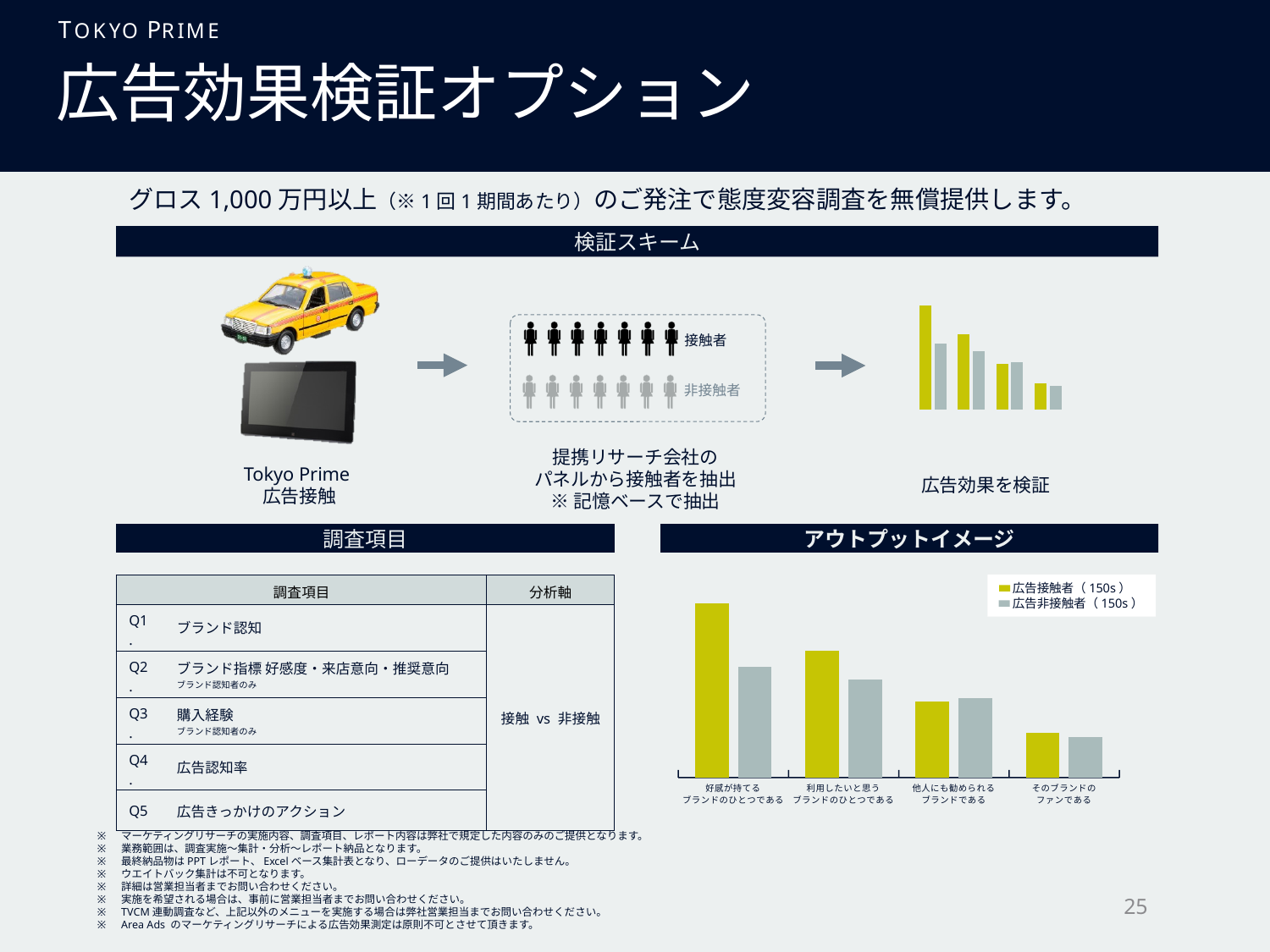
In the アウトプットイメージ chart, for 利用したいと思うブランドのひとつである, which series has the larger value: 広告接触者（150s） or 広告非接触者（150s）? 広告接触者（150s） In the アウトプットイメージ chart, what are the two legend entries? 広告接触者（150s）, 広告非接触者（150s） In the アウトプットイメージ chart, which category has the highest value for 広告非接触者（150s）? 好感が持てるブランドのひとつである What kind of chart is shown under the アウトプットイメージ heading? bar chart In the アウトプットイメージ chart, how many categories are shown on the x axis? 4 In the アウトプットイメージ chart, which category has the lowest value for 広告接触者（150s）? そのブランドのファンである In the アウトプットイメージ chart, which category has the lowest value for 広告非接触者（150s）? そのブランドのファンである In the アウトプットイメージ chart, which colour represents 広告接触者（150s）? yellow In the アウトプットイメージ chart, how many series does the legend list? 2 In the アウトプットイメージ chart, for 好感が持てるブランドのひとつである, which series has the larger value: 広告接触者（150s） or 広告非接触者（150s）? 広告接触者（150s） In the アウトプットイメージ chart, which category has the highest value for 広告接触者（150s）? 好感が持てるブランドのひとつである In the アウトプットイメージ chart, do the values for 広告接触者（150s） rise or fall from left to right across the categories? fall